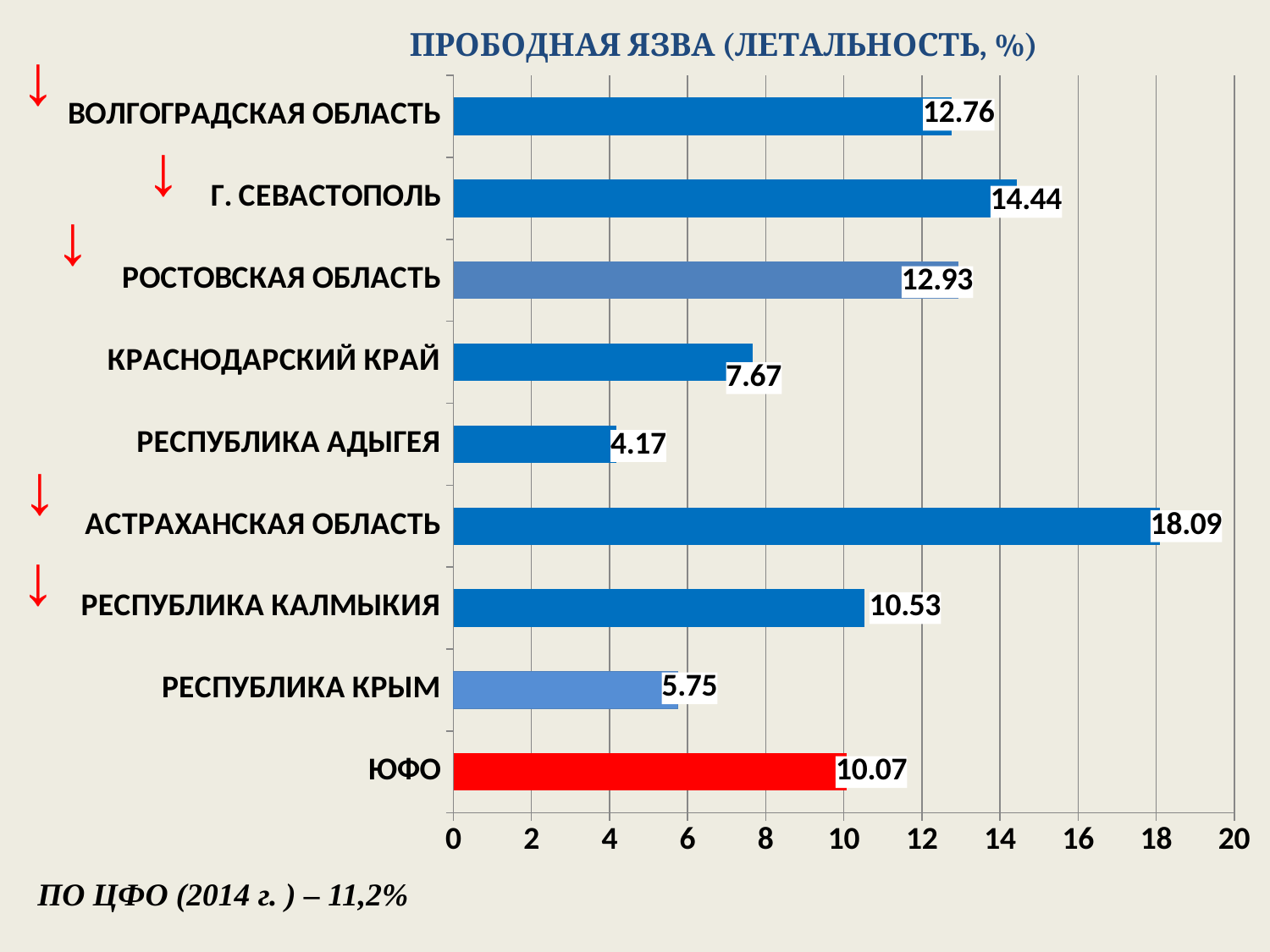
What is the value for Астраханская область? 18.09 Is the value for Краснодарский край greater or less than 8? less Which category's bar is coloured red? ЮФО How many categories are shown on the chart? 9 What is the difference between the values for Астраханская область and Республика Адыгея? 13.92 What kind of chart is shown on the slide? bar chart Which category has the lowest value? Республика Адыгея What is the title of the chart? ПРОБОДНАЯ ЯЗВА (ЛЕТАЛЬНОСТЬ, %) What is the value for Республика Крым? 5.75 Which is larger, the value for Г. Севастополь or the value for Ростовская область? Г. Севастополь Which category has the highest value? Астраханская область What is the value for ЮФО? 10.07